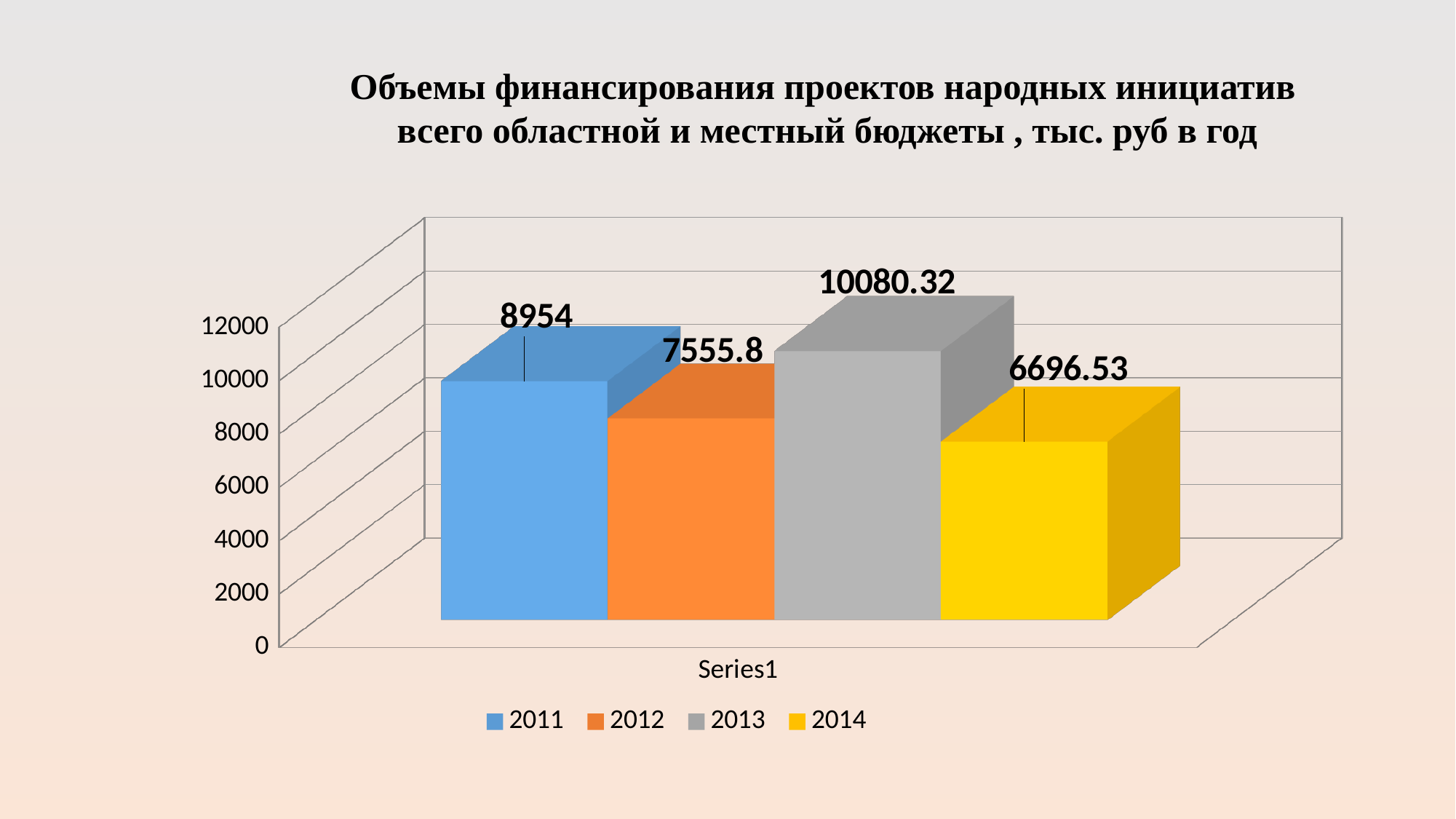
What colour is the bar for 2013? grey Which year has the lowest value? 2014 Which year has the highest value? 2013 What is the difference between the values for 2011 and 2012? 1398.2 What is the value for 2011? 8954 What is the value for 2013? 10080.32 What kind of chart is shown on the slide? bar chart What is the value for 2014? 6696.53 Which is larger, the value for 2012 or the value for 2014? 2012 What is the value for 2012? 7555.8 What is the difference between the values for 2013 and 2011? 1126.32 How many series does the legend list? 4